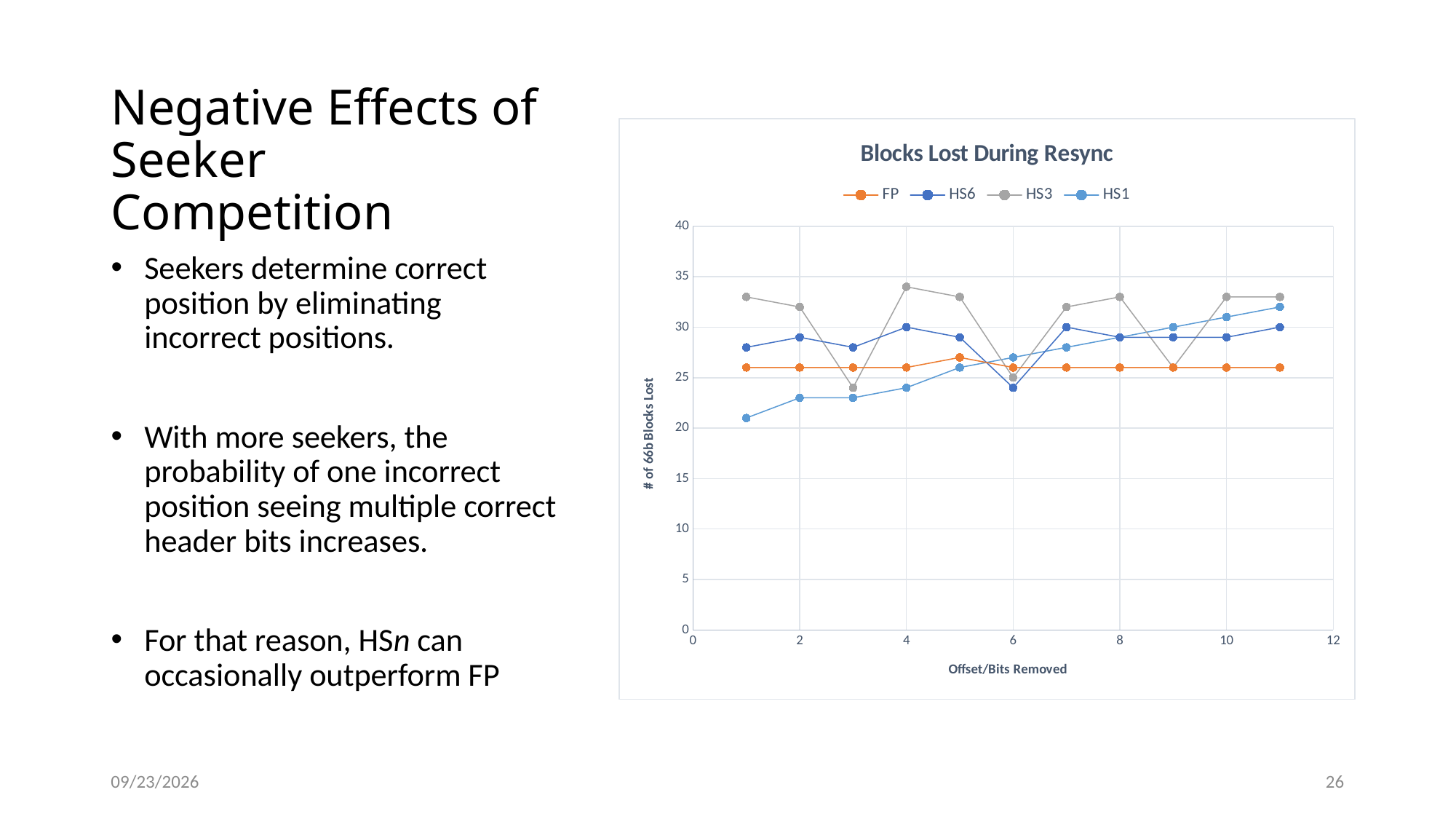
At offset 4, which series has the larger value, HS3 or HS1? HS3 How many data points does the HS1 series have? 11 What is the label of the x axis of the chart? Offset/Bits Removed What kind of chart is shown on the slide? line chart What is the title of the chart? Blocks Lost During Resync Does the HS1 series generally rise or fall as the offset increases? rise Is the value for FP at offset 2 greater or less than 30? less Is the value for HS3 at offset 1 greater or less than 30? greater Which series has the highest value at offset 1? HS3 Is the value for HS1 at offset 1 greater or less than 25? less How many series does the chart legend list? 4